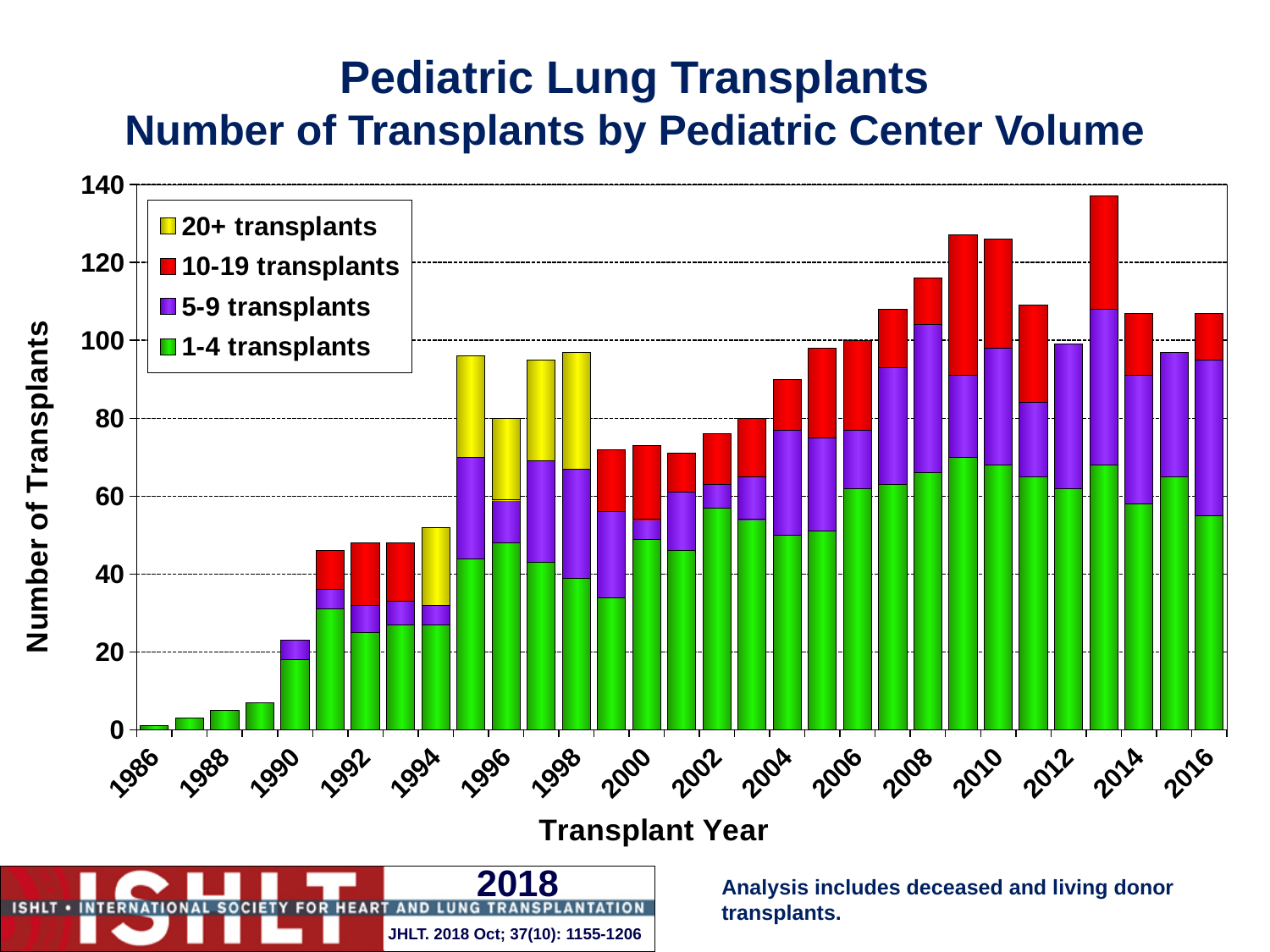
What kind of chart is shown on the slide? stacked bar chart Is the total number of transplants in 1995 greater or less than 60? greater Which colour represents the 20+ transplants series in the legend? yellow Which year has a larger total number of transplants, 1990 or 1996? 1996 Do the total number of transplants rise or fall from 1986 to 1990? rise Is the total number of transplants in 2013 greater or less than 120? greater Which transplant year has the lowest total number of transplants? 1986 Is the number of transplants at 1-4 transplant centers in 2009 greater or less than 60? greater Which transplant year has the highest total number of transplants? 2013 How many series does the legend list? 4 Which year has a larger total number of transplants, 2013 or 2010? 2013